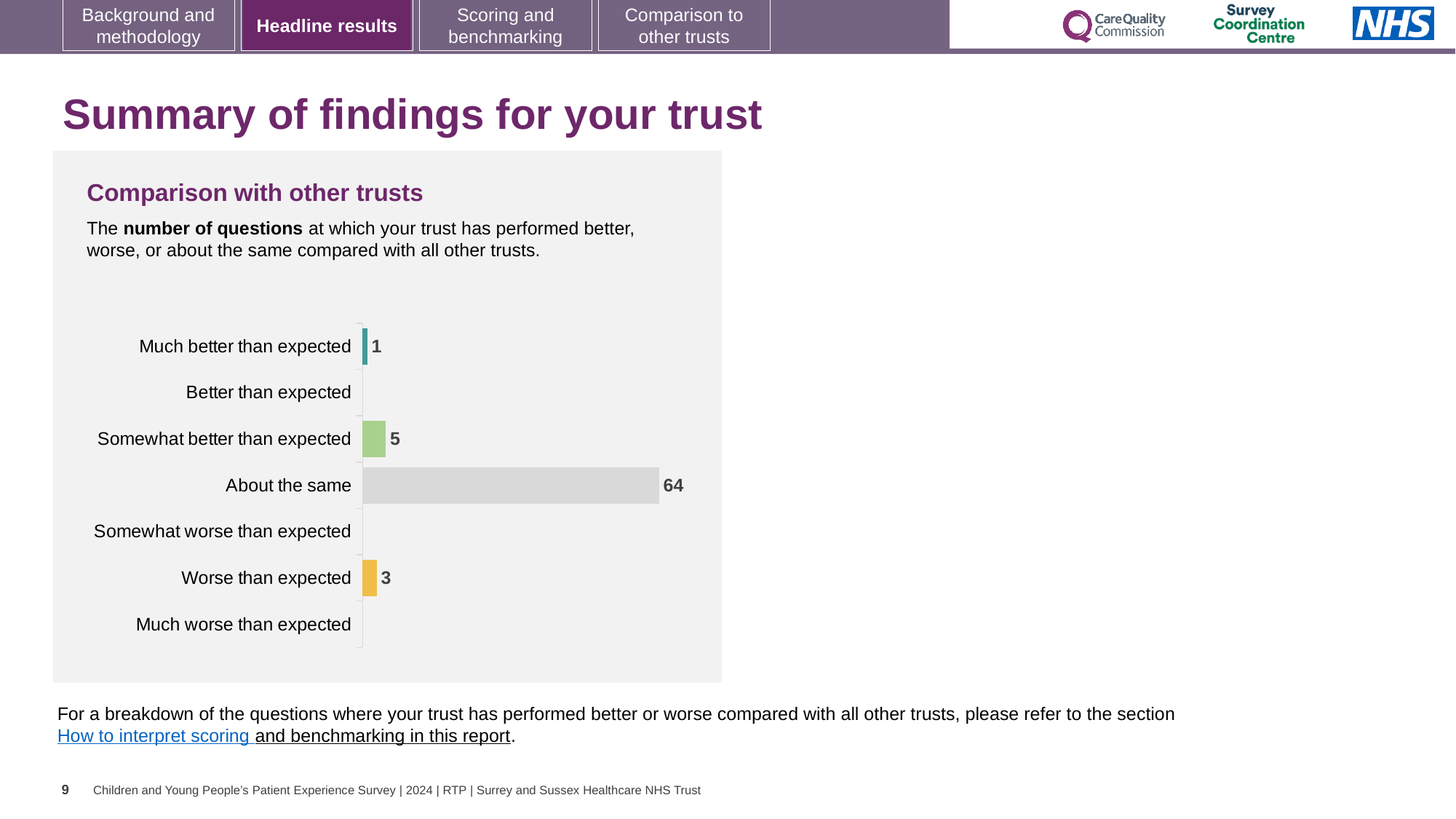
How many categories are shown on the chart? 7 Which is larger, 'Worse than expected' or 'Much better than expected'? Worse than expected What is the value for 'Worse than expected'? 3 How many questions were rated 'About the same'? 64 What is the title of the chart? Comparison with other trusts What is the value for 'Much better than expected'? 1 What colour is the bar for 'Worse than expected'? Orange What is the difference between 'Somewhat better than expected' and 'Worse than expected'? 2 What kind of chart is shown on the slide? Bar chart What is the value for 'Somewhat better than expected'? 5 Which category has the highest number of questions? About the same What is the difference between 'About the same' and 'Somewhat better than expected'? 59